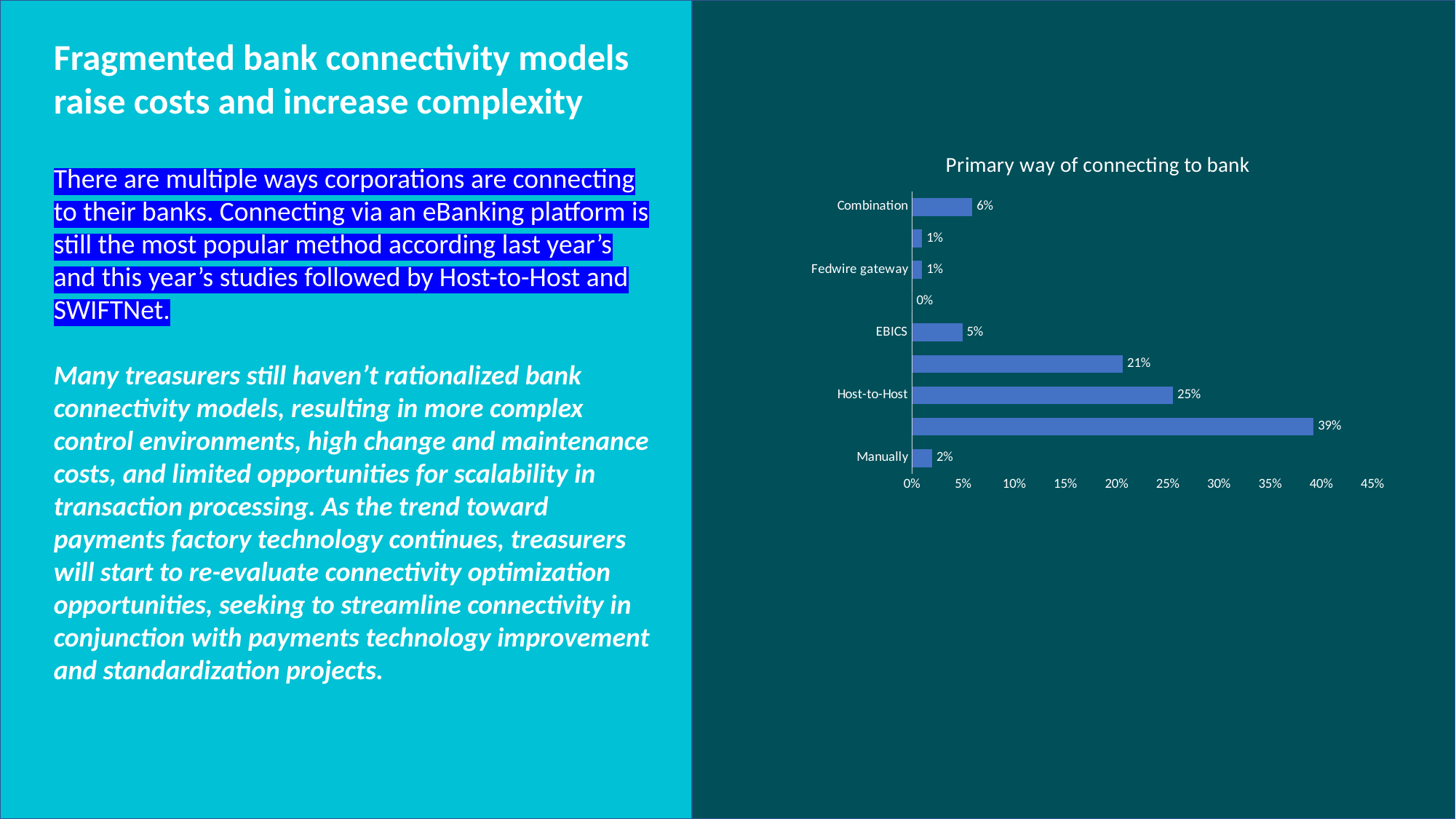
What is the value for Combination? 6% What is the highest value shown on the horizontal axis? 45% What is the title of the chart? Primary way of connecting to bank What is the value for Host-to-Host? 25% How many bars are plotted in the chart? 9 What is the value for Manually? 2% What is the value for Fedwire gateway? 1% What is the value for EBICS? 5% Which is larger, the value for Host-to-Host or the value for EBICS? Host-to-Host What is the difference between the values for Host-to-Host and Combination? 19% What type of chart is shown on the slide? bar chart What is the largest value shown by any bar in the chart? 39%